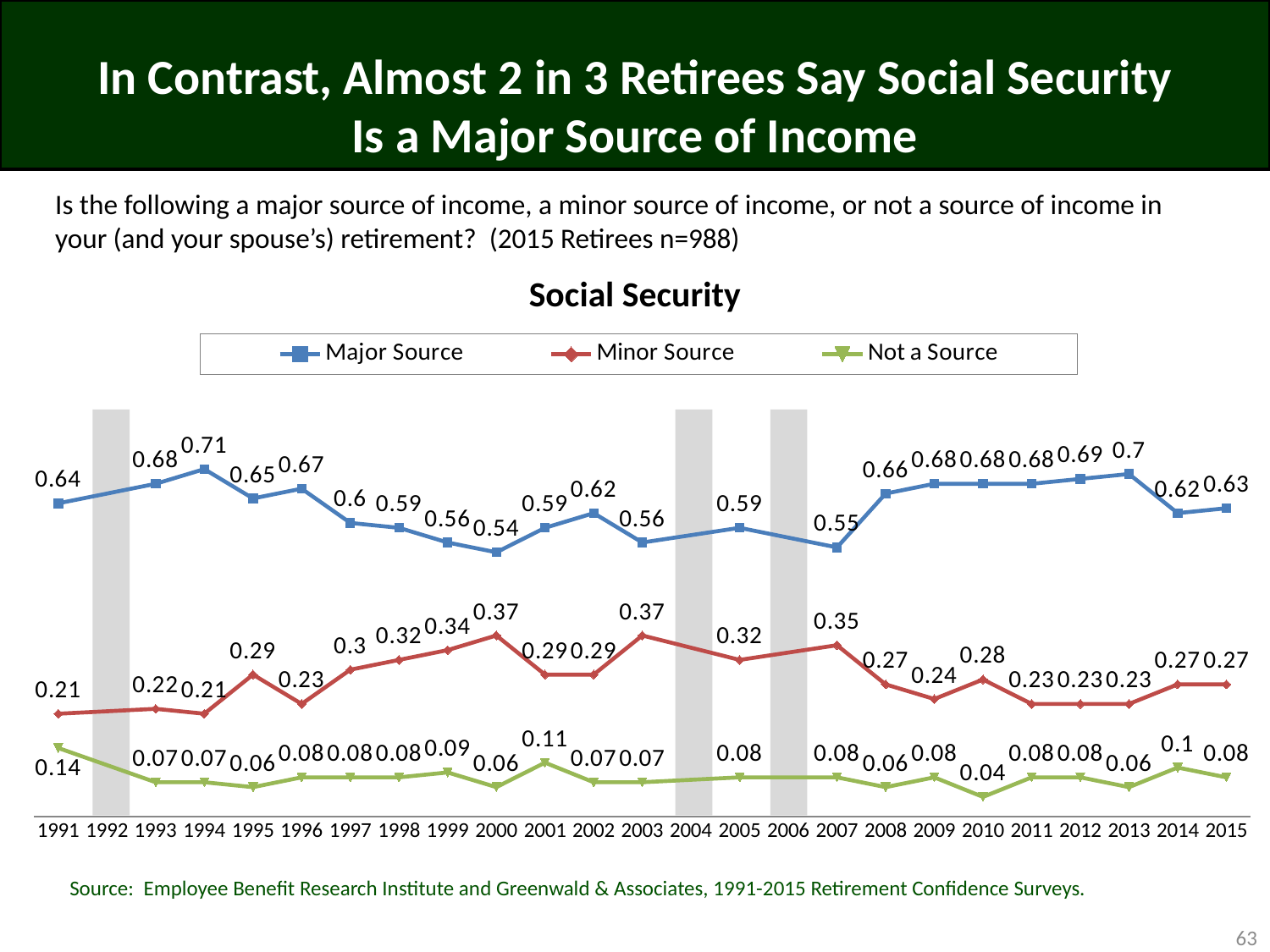
How many series does the legend list? 3 Which is larger in 2007: the Minor Source value or the Not a Source value? Minor Source What is the difference between the Major Source value in 2013 and in 2014? 0.08 In which year is the Major Source value lowest? 2000 In which year is the Not a Source value lowest? 2010 Which series is drawn in green? Not a Source What is the value for Not a Source in 1991? 0.14 What type of chart is shown on the slide? line chart What is the title of the chart? Social Security What is the value for Minor Source in 2000? 0.37 What is the value for Major Source in 2015? 0.63 In which year is the Major Source value highest? 1994